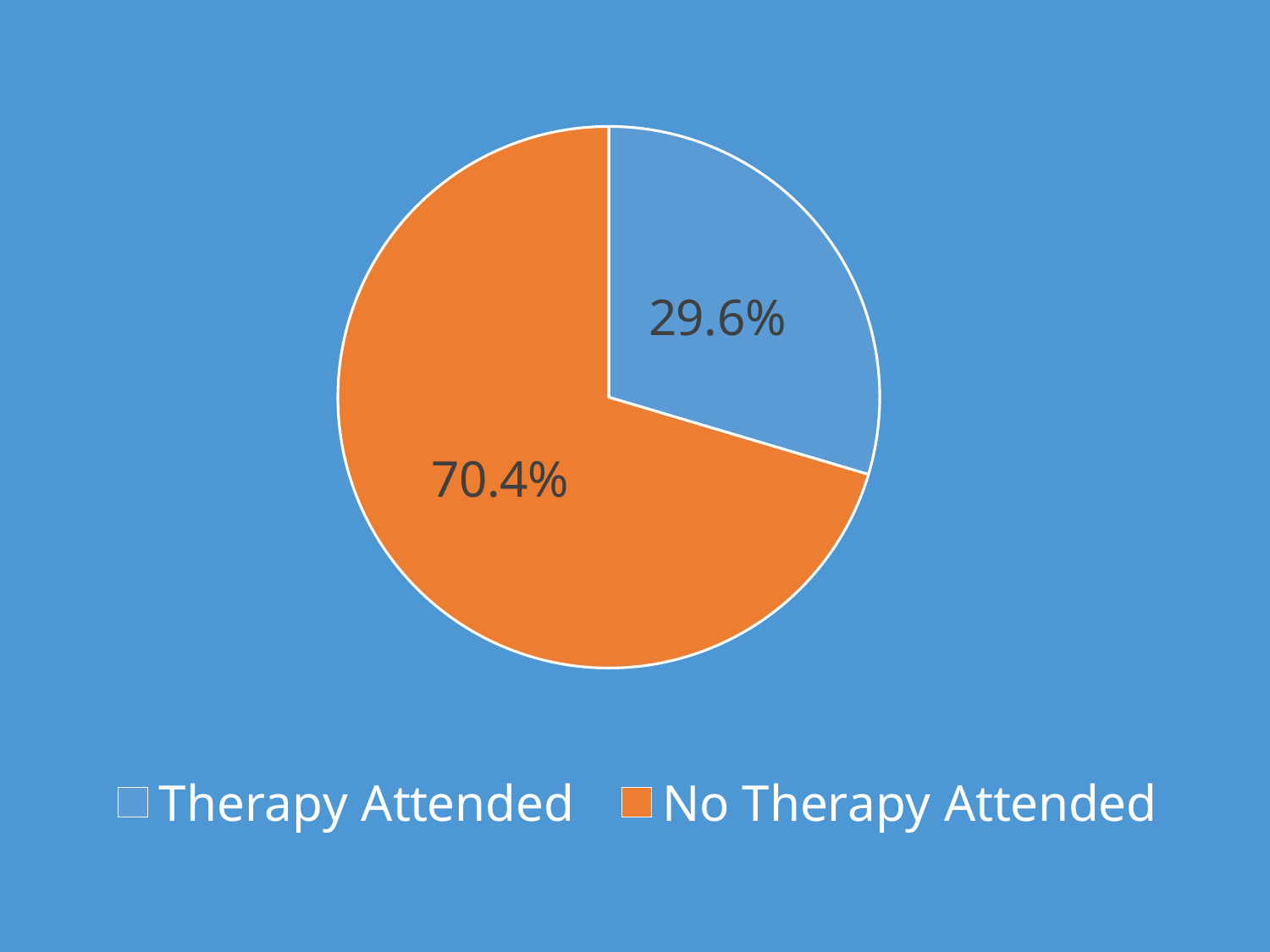
What kind of chart is shown on the slide? pie chart Where is the legend positioned on the slide? below the chart Which is larger, Therapy Attended or No Therapy Attended? No Therapy Attended How many entries does the legend list? 2 Which slice is the smallest? Therapy Attended How many slices does the pie chart have? 2 What share of the pie is labelled Therapy Attended? 29.6% What share of the pie is labelled No Therapy Attended? 70.4% What colour is the No Therapy Attended slice? orange What is the difference in percentage points between No Therapy Attended and Therapy Attended? 40.8 Which slice is the largest? No Therapy Attended